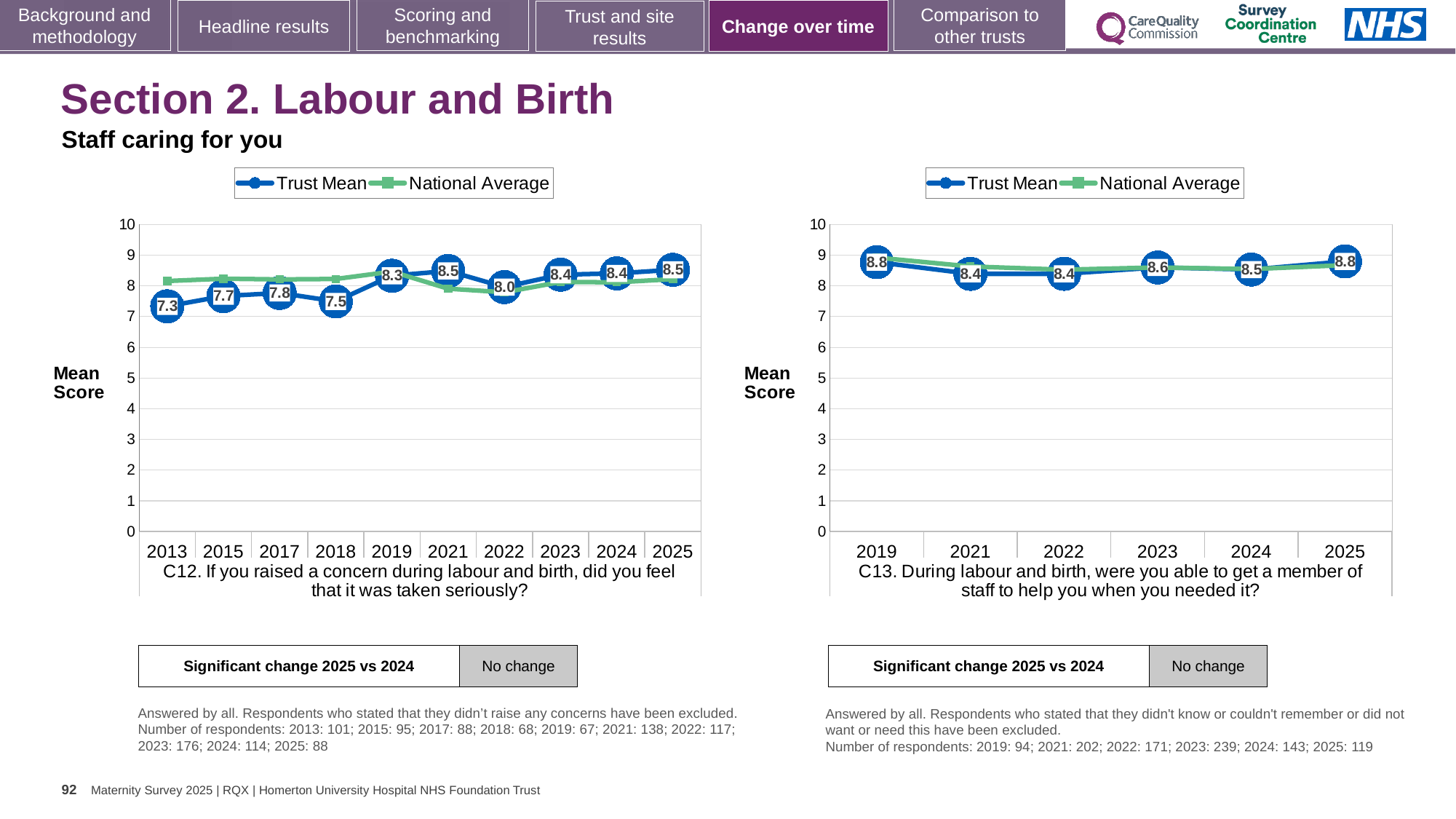
In the left chart (C12), what is the difference between the Trust Mean scores for 2025 and 2013? 1.2 In the left chart (C12), is the Trust Mean score higher in 2019 or in 2018? 2019 In the left chart (C12), what is the Trust Mean score for 2013? 7.3 In the right chart (C13), what is the Trust Mean score for 2023? 8.6 What type of chart is the left chart (C12)? Line chart How many series does the legend of the right chart (C13) list? 2 In the left chart (C12), which year has the lowest Trust Mean score? 2013 In the left chart (C12), what is the Trust Mean score for 2022? 8.0 In the right chart (C13), is the National Average for 2019 greater or less than 8? greater In the right chart (C13), what is the difference between the Trust Mean scores for 2019 and 2021? 0.4 In the right chart (C13), which year has the lowest Trust Mean score? 2021 and 2022 How many years are plotted on the x axis of the left chart (C12)? 10